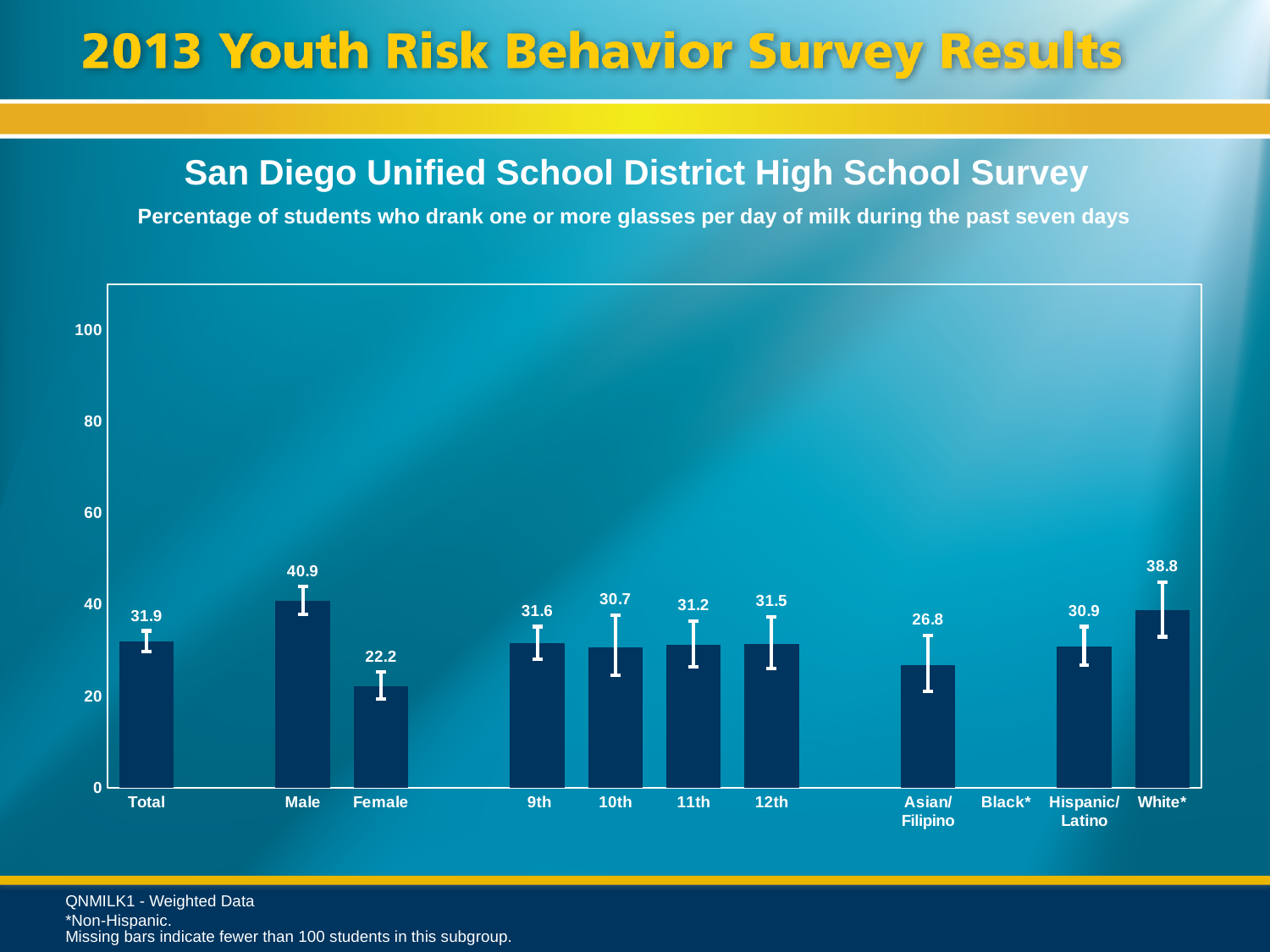
Is the value for 12th grade students greater or less than 40? less How many categories are labeled on the x axis? 11 What is the difference between the Male and Female values? 18.7 Which category has the lowest value among the bars shown? Female What percentage of students in the Total category drank one or more glasses of milk per day during the past seven days? 31.9 What is the value shown for Male students? 40.9 Which is larger, the value for White* or the value for Hispanic/Latino? White* Which category has the highest value on the chart? Male What type of chart is shown on the slide? bar chart What is the value shown for Asian/Filipino students? 26.8 Which category on the x axis has no bar shown? Black* What is the value shown for Female students? 22.2